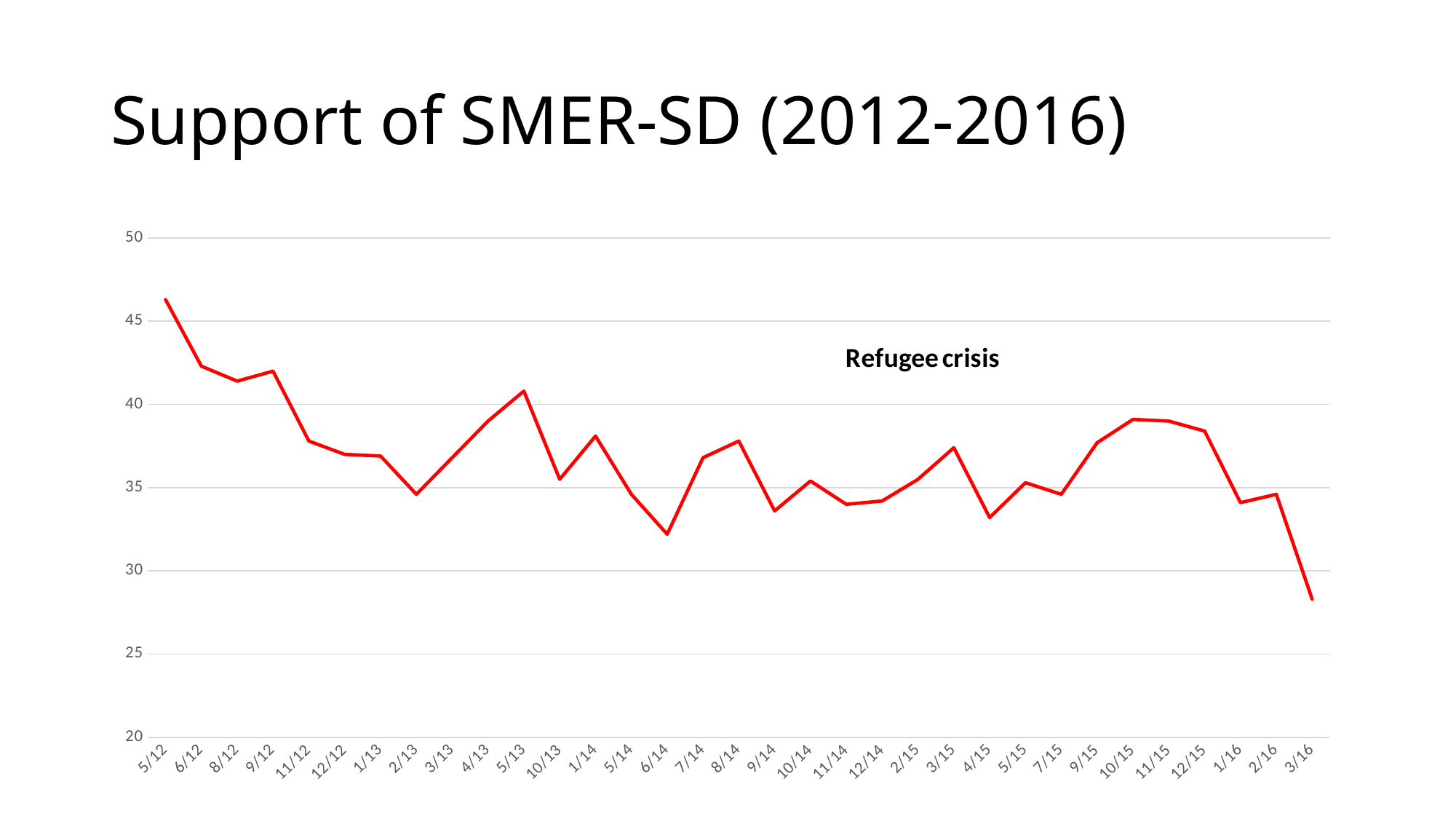
What kind of chart is shown on the slide? line chart At which date is the support value lowest? 3/16 Is the value for 5/12 greater or less than 45? greater How many data points are plotted along the x axis? 33 Is the value for 6/14 greater or less than 35? less Overall, do the values rise or fall from 5/12 to 3/16? fall Which has the higher value, 5/13 or 6/14? 5/13 What text annotation is placed above the line in the chart? Refugee crisis Is the value for 3/16 greater or less than 30? less At which date is the support value highest? 5/12 What is the title of the chart? Support of SMER-SD (2012-2016)